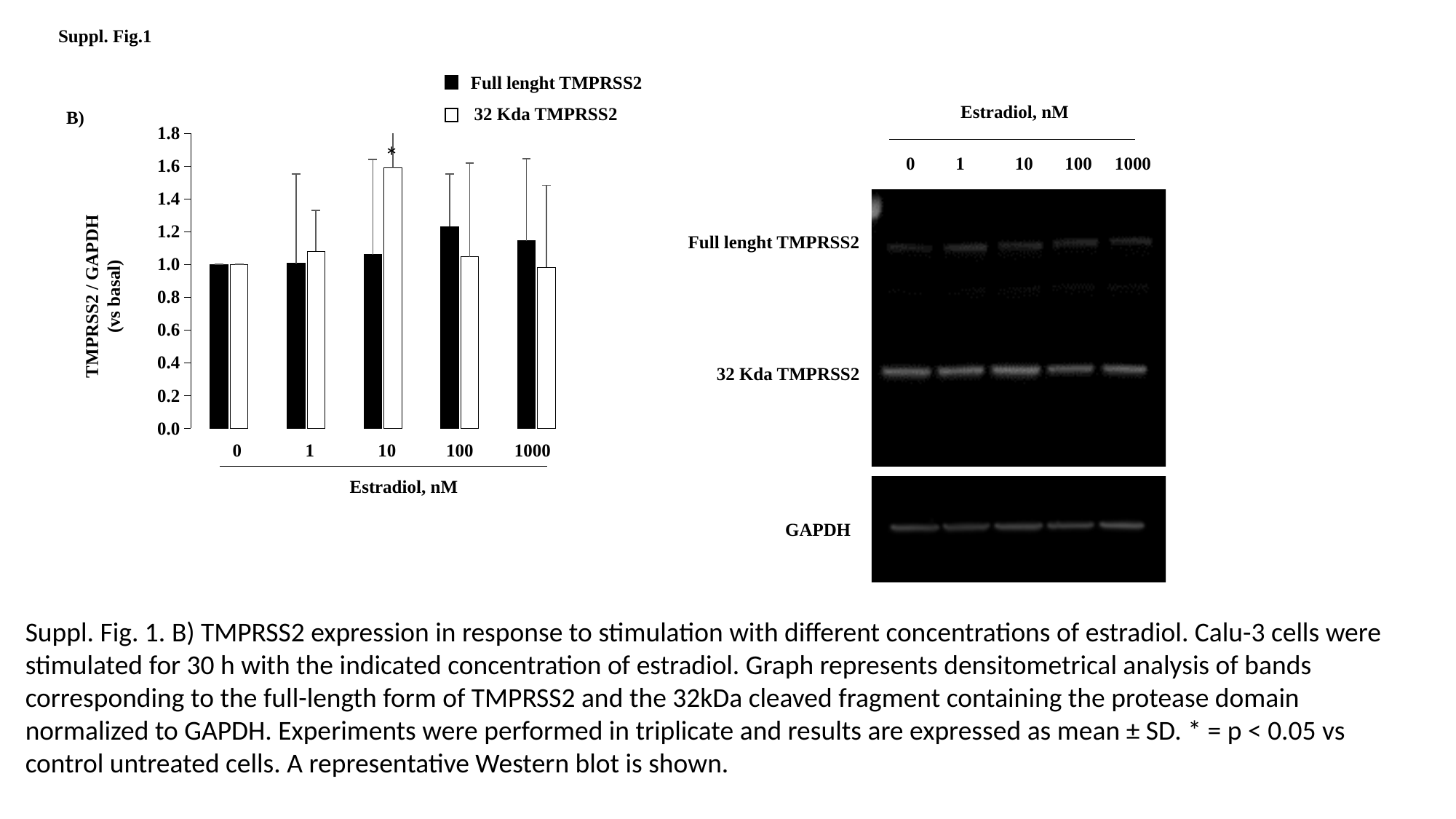
At which estradiol concentration is the 32 Kda TMPRSS2 bar highest? 10 Is the value for 32 Kda TMPRSS2 at 10 nM estradiol greater or less than 1.4? greater At 10 nM estradiol, which series has the larger value, Full lenght TMPRSS2 or 32 Kda TMPRSS2? 32 Kda TMPRSS2 What is the value for Full lenght TMPRSS2 at 0 nM estradiol? 1.0 Is the value for Full lenght TMPRSS2 at 100 nM estradiol greater or less than 1.0? greater What is the x-axis label of the bar chart? Estradiol, nM Is the value for 32 Kda TMPRSS2 at 1000 nM estradiol greater or less than 1.2? less How many series does the legend of the bar chart list? 2 What is the value for 32 Kda TMPRSS2 at 0 nM estradiol? 1.0 How many estradiol concentrations are shown on the x axis of the bar chart? 5 Which series is shown with black bars in the bar chart? Full lenght TMPRSS2 What kind of chart is shown in panel B? Bar chart